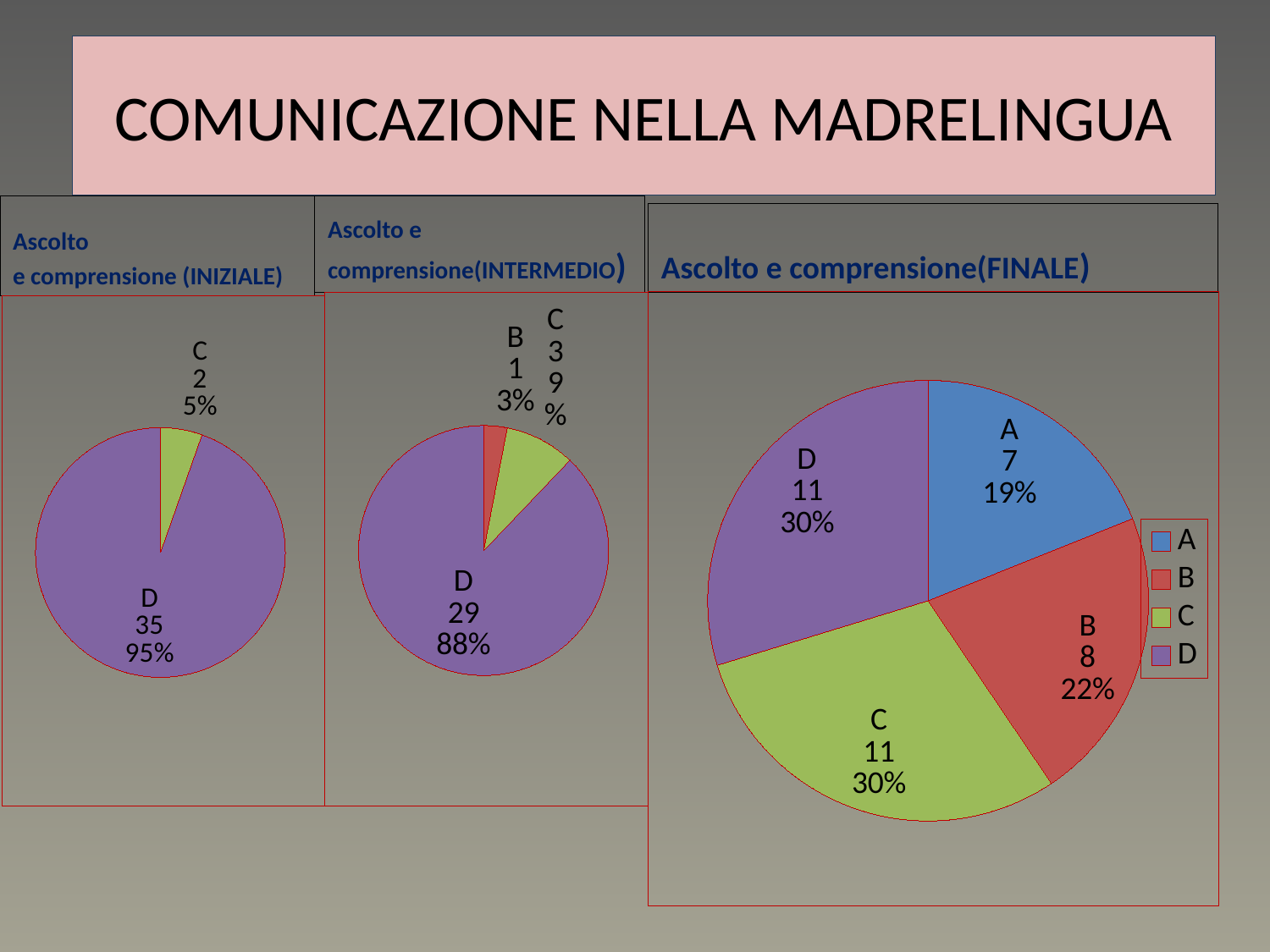
In the 'Ascolto e comprensione (INIZIALE)' chart, what share of the pie does C have? 5% In the 'Ascolto e comprensione(FINALE)' chart, how many categories are shown? 4 In the 'Ascolto e comprensione(FINALE)' chart, what percentage is shown for B? 22% In the 'Ascolto e comprensione(INTERMEDIO)' chart, what percentage is shown for D? 88% In the 'Ascolto e comprensione(FINALE)' chart, what is the value for A? 7 In the 'Ascolto e comprensione(FINALE)' chart, which category has the smallest slice? A In the 'Ascolto e comprensione(INTERMEDIO)' chart, which category has the smallest slice? B In the 'Ascolto e comprensione(FINALE)' chart, how many entries does the legend list? 4 In the 'Ascolto e comprensione(INTERMEDIO)' chart, what is the value for C? 3 In the 'Ascolto e comprensione(FINALE)' chart, what is the difference between the values for B and A? 1 In the 'Ascolto e comprensione (INIZIALE)' chart, what is the value for D? 35 What kind of chart is 'Ascolto e comprensione(FINALE)'? Pie chart